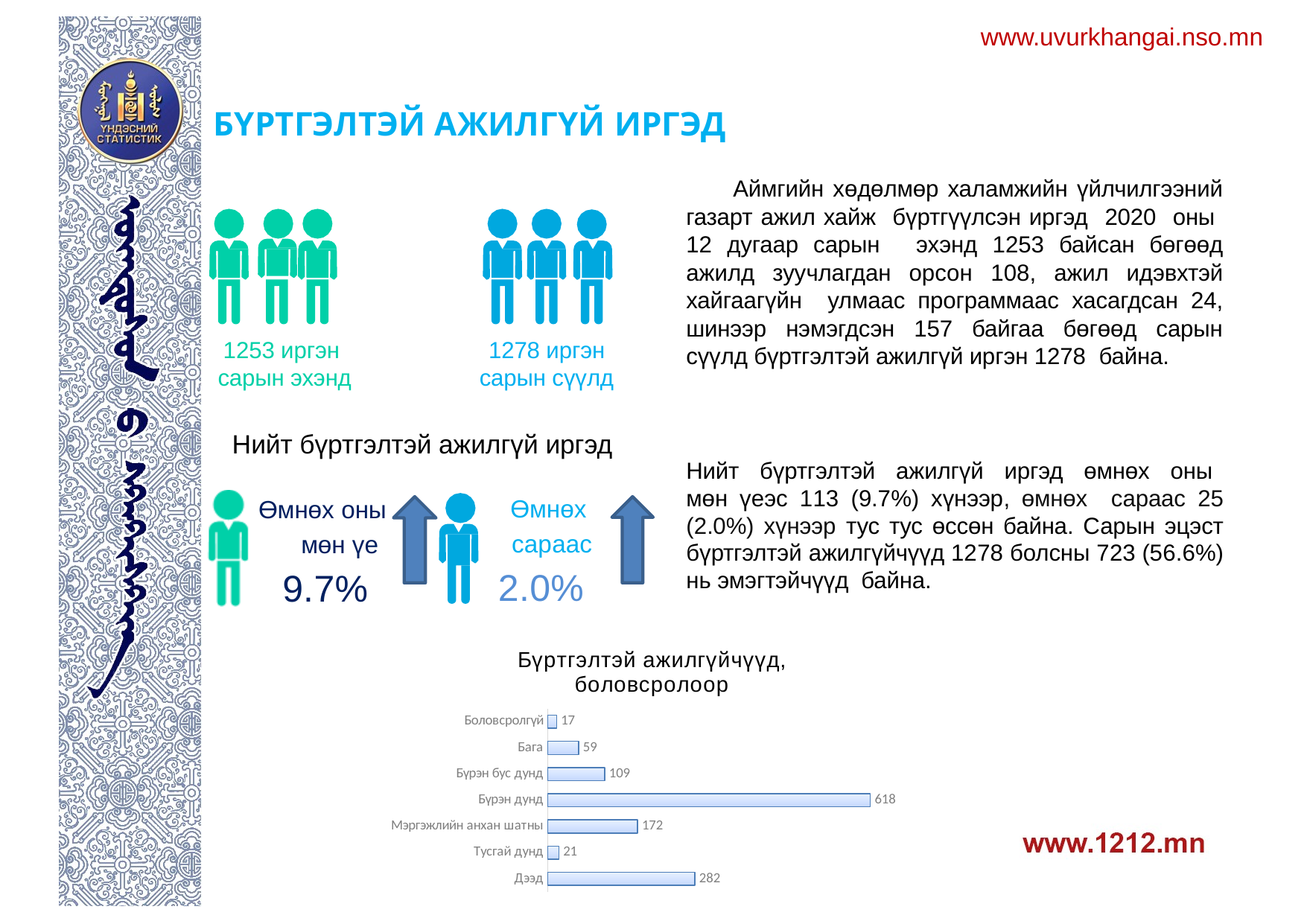
What is the difference between the values for Бүрэн дунд and Дээд? 336 What is the value for Дээд in the chart? 282 Which category has the lowest value in the chart? Боловсролгүй Which category has the highest value in the chart? Бүрэн дунд What is the value for Бага in the chart? 59 What kind of chart is shown on the slide? Bar chart How many categories are shown in the chart? 7 Which is larger, the value for Тусгай дунд or the value for Боловсролгүй? Тусгай дунд What is the value for Бүрэн дунд in the chart? 618 What is the difference between the values for Бүрэн бус дунд and Бага? 50 What is the title of the chart? Бүртгэлтэй ажилгүйчүүд, боловсролоор What is the value for Мэргэжлийн анхан шатны in the chart? 172